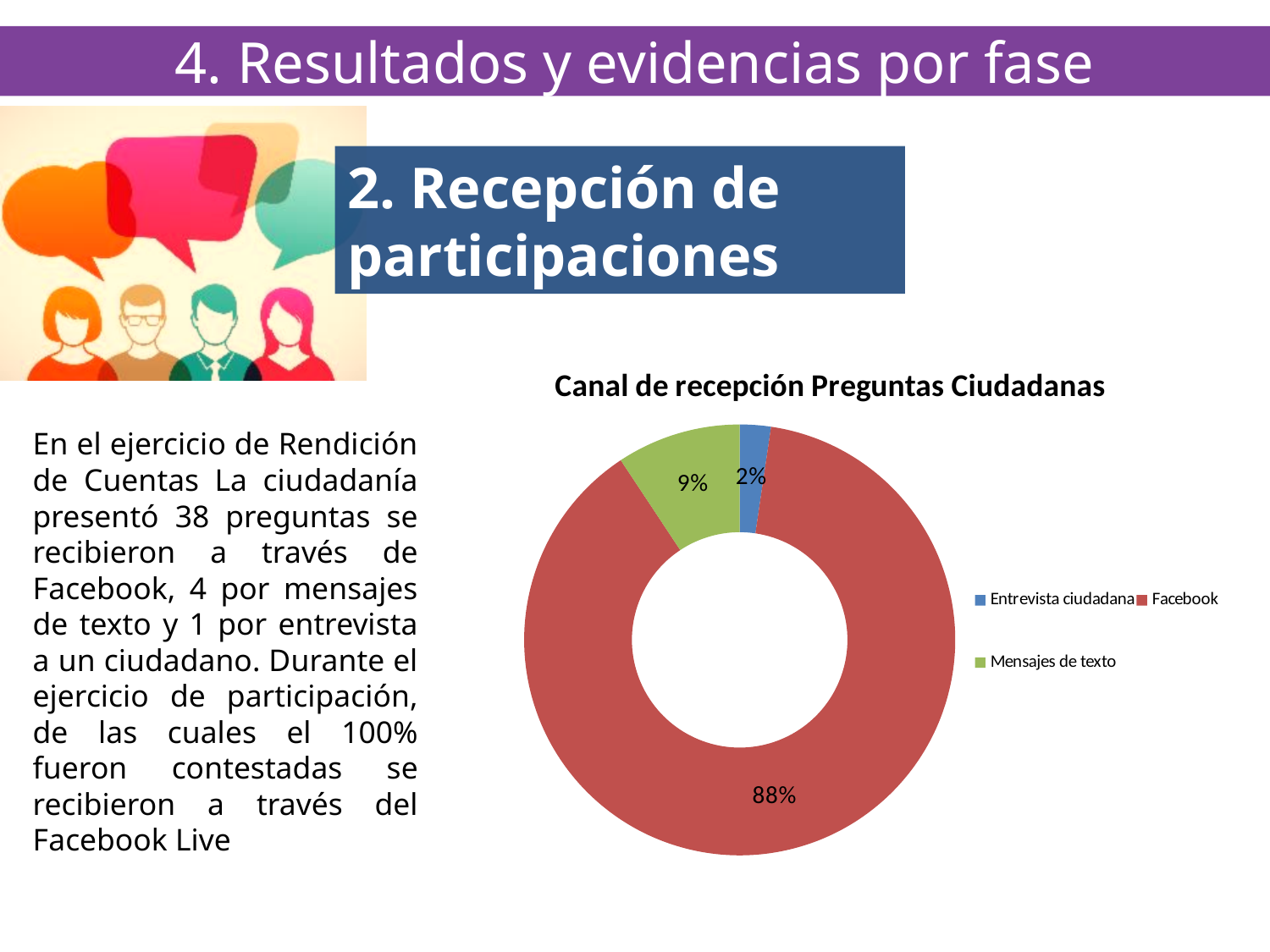
Which is larger, the share for Mensajes de texto or the share for Entrevista ciudadana? Mensajes de texto What is the title of the chart on the slide? Canal de recepción Preguntas Ciudadanas How many categories does the legend of the chart list? 3 Which category has the smallest share in the chart? Entrevista ciudadana Which category has the largest share in the chart? Facebook What kind of chart is shown on the slide? Doughnut (pie) chart What share of the chart does Facebook represent? 88% What share of the chart does Entrevista ciudadana represent? 2% What share of the chart does Mensajes de texto represent? 9% What colour represents Facebook in the chart? Red Is the share for Facebook greater or less than 50%? greater What is the difference in percentage points between the Facebook share and the Mensajes de texto share? 79 percentage points